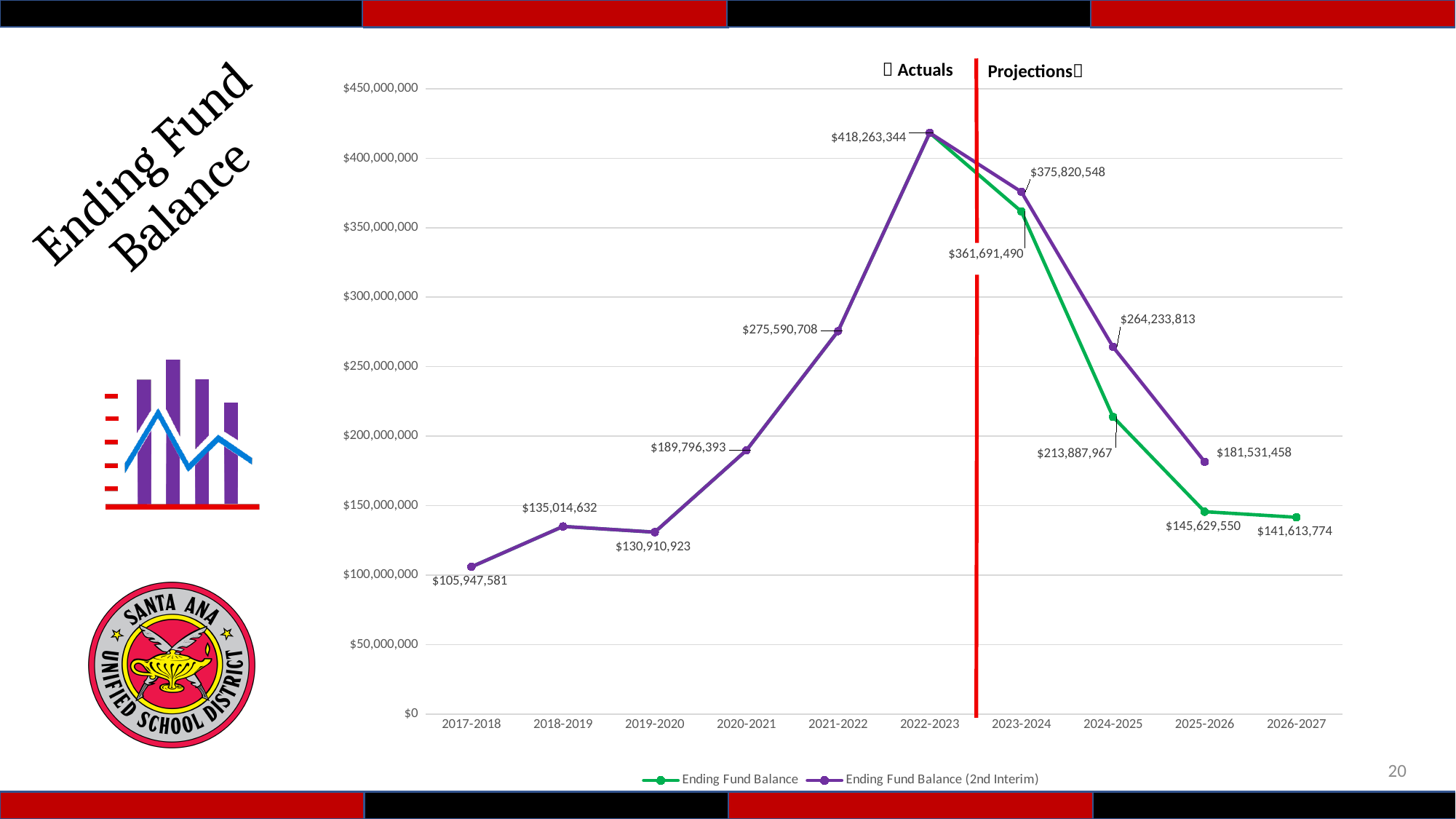
For 2025-2026, which series has the larger value: Ending Fund Balance or Ending Fund Balance (2nd Interim)? Ending Fund Balance (2nd Interim) What is the ending fund balance shown for 2017-2018? $105,947,581 What is the difference between the Ending Fund Balance (2nd Interim) and the Ending Fund Balance values for 2024-2025? $50,345,846 What is the Ending Fund Balance (2nd Interim) value for 2023-2024? $375,820,548 What is the Ending Fund Balance value for 2026-2027? $141,613,774 Which year has the highest ending fund balance on the chart? 2022-2023 Which year has the lowest ending fund balance on the chart? 2017-2018 How many series does the legend list? 2 How many fiscal years are shown on the x axis? 10 What is the Ending Fund Balance value for 2024-2025? $213,887,967 What kind of chart is shown on the slide? Line chart Is the Ending Fund Balance (2nd Interim) value for 2025-2026 greater or less than $200,000,000? less